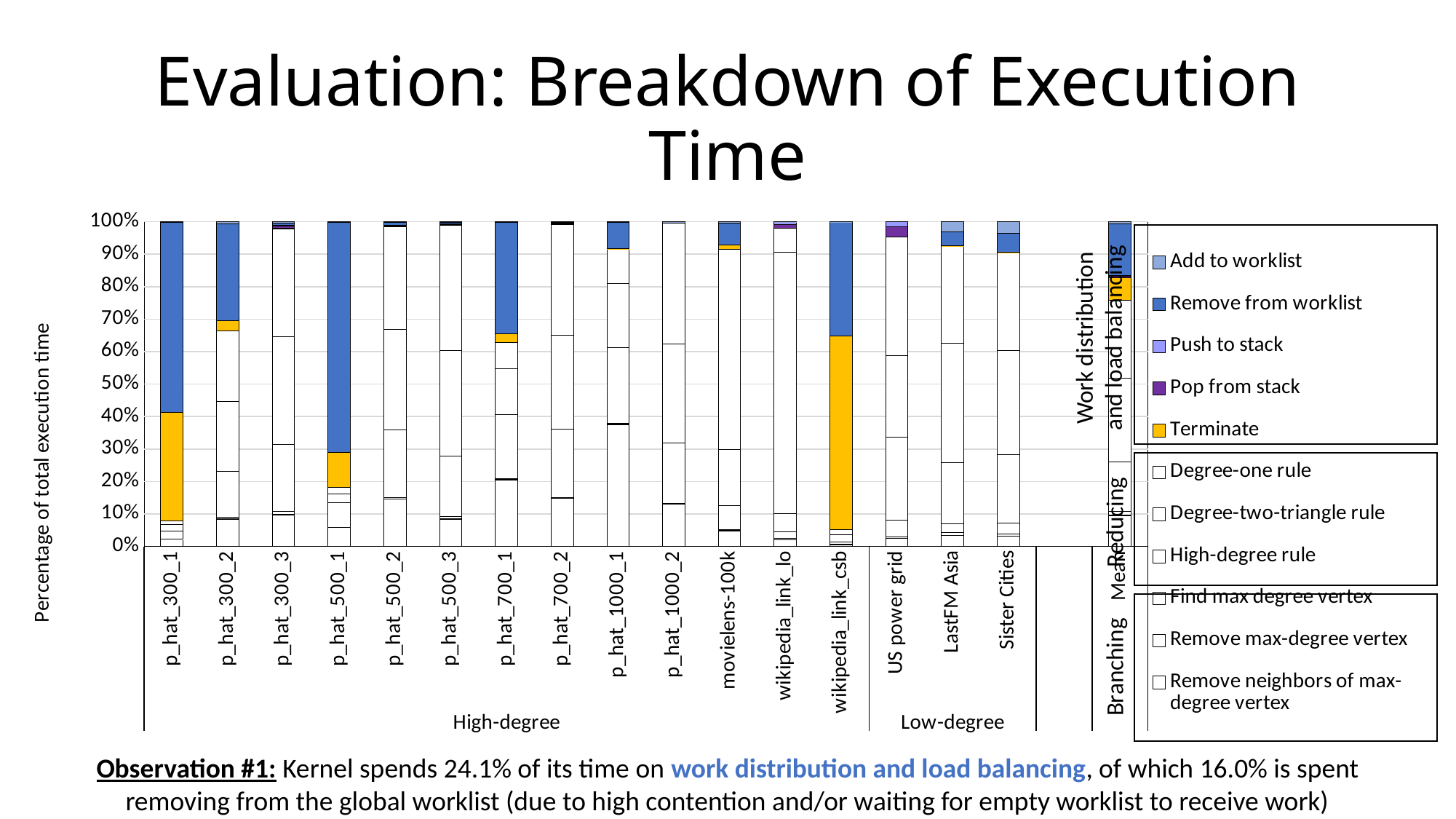
Is the Remove from worklist share for p_hat_300_1 greater or less than 50%? greater How many series does the legend list? 11 Is the Remove from worklist share for p_hat_500_1 greater or less than 60%? greater Which has a larger Terminate share, wikipedia_link_csb or p_hat_300_1? wikipedia_link_csb Is the Terminate share for p_hat_300_2 greater or less than 10%? less Which has a larger Remove from worklist share, p_hat_500_1 or p_hat_500_3? p_hat_500_1 Which two groups are the graph categories divided into along the x axis? High-degree and Low-degree Which category has the largest Terminate (yellow) segment? wikipedia_link_csb What kind of chart is shown on the slide? Stacked bar chart What is the label of the y axis? Percentage of total execution time